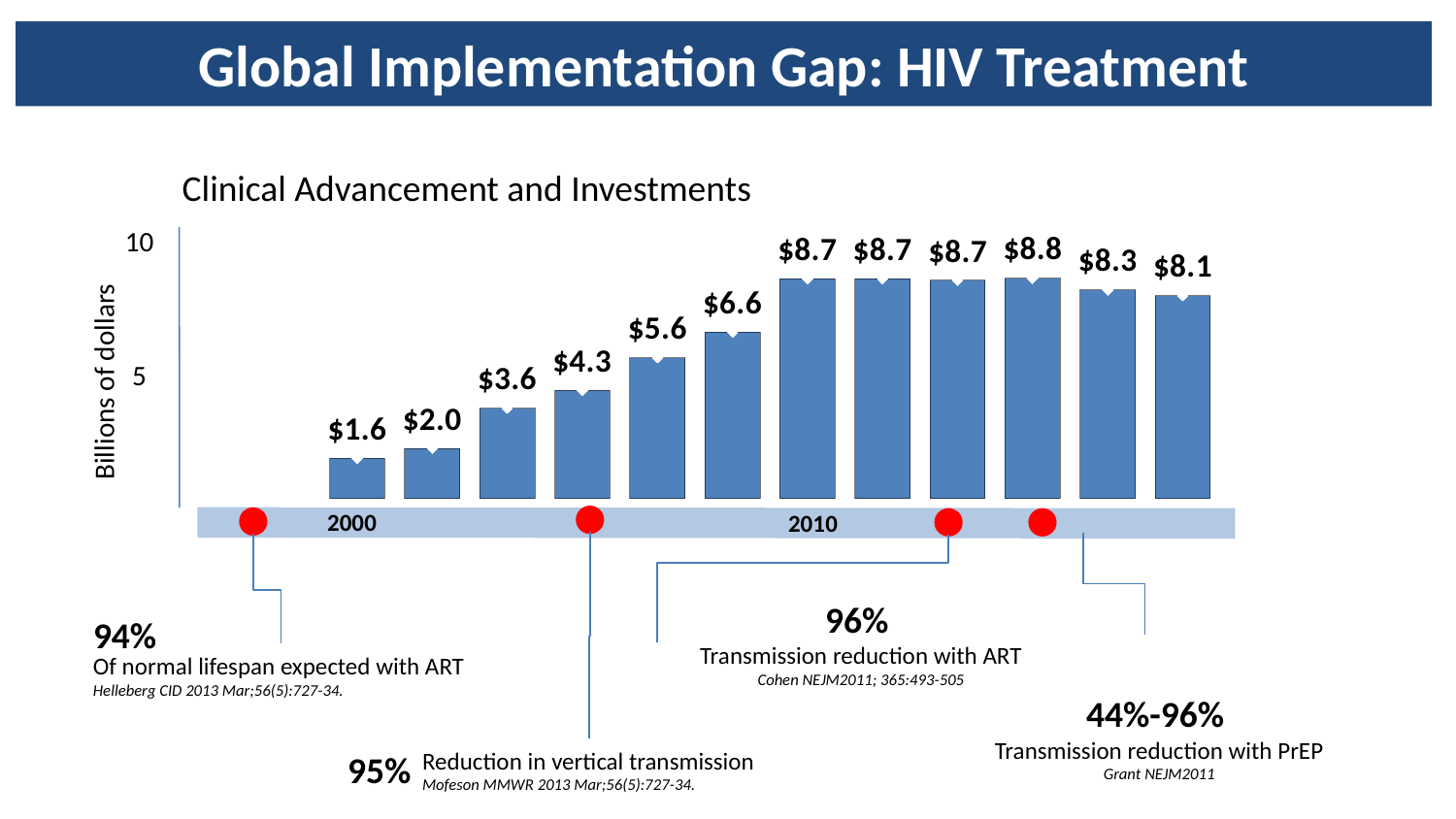
Is the value for 2010 greater or less than 5 on the y axis? greater What is the difference between the highest bar value ($8.8) and the last bar value ($8.1)? $0.7 What is the lowest value shown on any bar in the chart? $1.6 What is the difference between the value at 2010 ($8.7) and the value at 2000 ($1.6)? $7.1 What is the value of the bar above the 2010 label on the timeline? $8.7 Which is larger, the value of the first bar or the value of the second bar? the second bar ($2.0) Do the bar values generally rise or fall from 2000 to 2010? rise What is the highest value shown on any bar in the chart? $8.8 What is the value of the sixth bar from the left? $6.6 How many bars are plotted in the chart? 12 What is the value of the bar above the 2000 label on the timeline? $1.6 What kind of chart is shown on the slide? bar chart